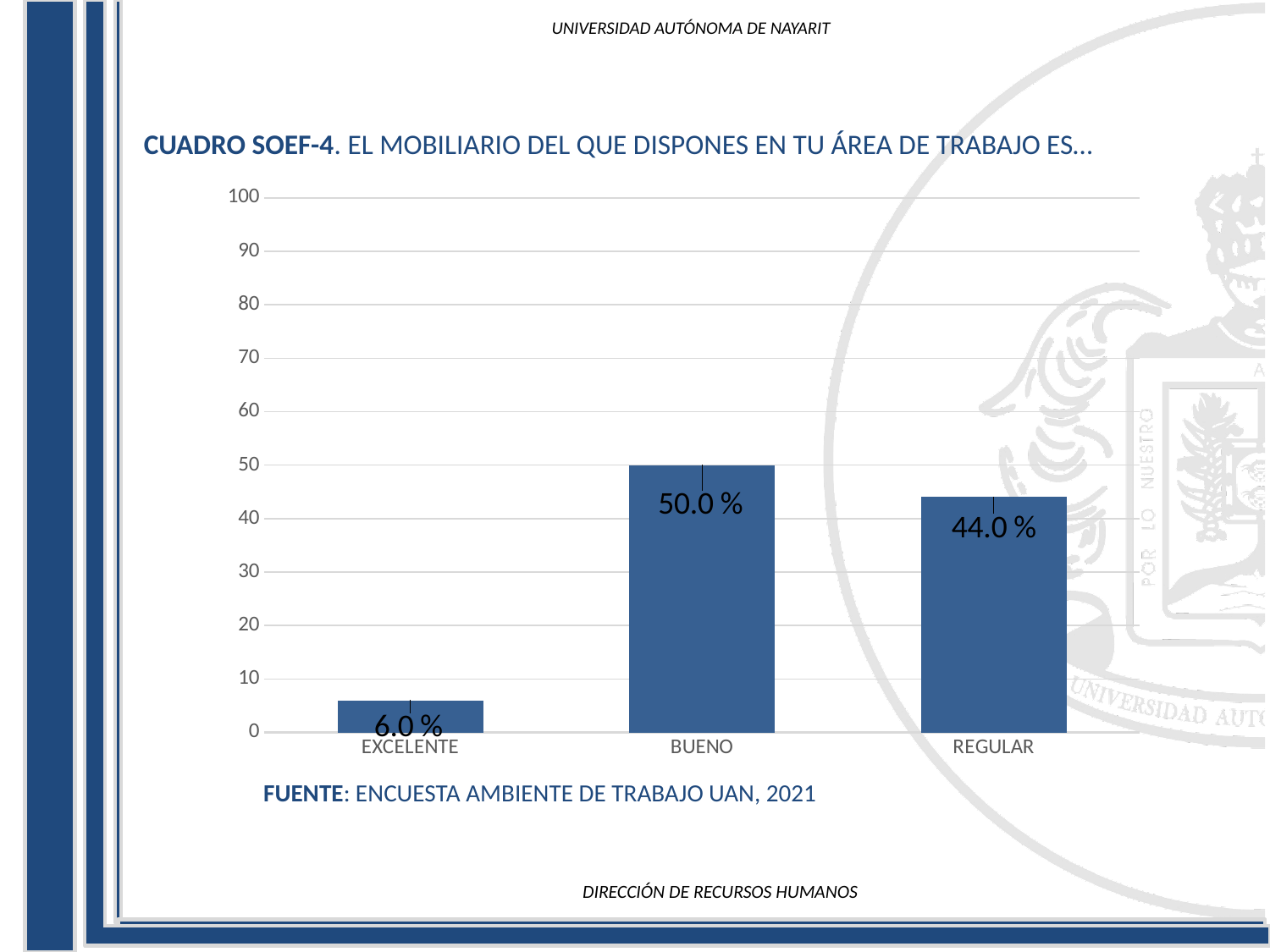
What source is cited below the chart? ENCUESTA AMBIENTE DE TRABAJO UAN, 2021 What kind of chart is shown on the slide? bar chart What is the difference between the values for BUENO and REGULAR? 6.0 % What is the value for BUENO? 50.0 % How many categories are shown on the x axis? 3 What is the difference between the values for REGULAR and EXCELENTE? 38.0 % Which is larger, the value for EXCELENTE or the value for REGULAR? REGULAR What is the value for REGULAR? 44.0 % Which category has the highest value? BUENO Is the value for REGULAR greater or less than 40? greater What is the value for EXCELENTE? 6.0 % Which category has the lowest value? EXCELENTE